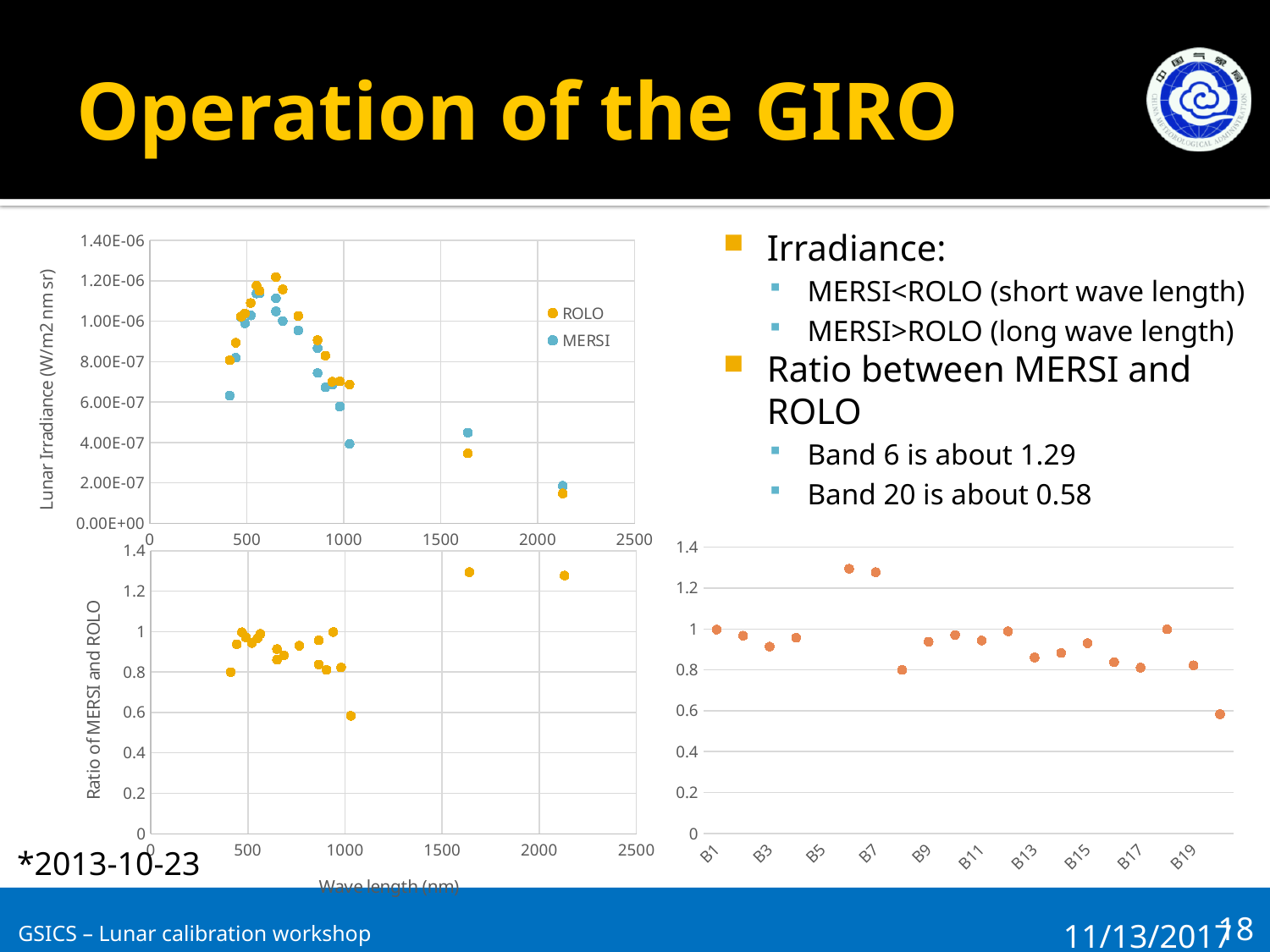
In the bottom-right chart of ratio by band, is the value for B20 greater or less than 0.8? less In the bottom-right chart of ratio by band, which is larger, the value for B6 or the value for B20? B6 In the bottom-right chart of ratio by band, is the value for B6 greater or less than 1.2? greater In the top-left Lunar Irradiance chart, at the longest wavelength plotted (around 2100 nm), which series has the larger value, MERSI or ROLO? MERSI In the bottom-right chart of ratio by band, how many bands (points) are plotted? 19 In the top-left Lunar Irradiance chart, how many series does the legend list? 2 In the top-left Lunar Irradiance chart, do the ROLO values rise or fall as wavelength increases from about 700 nm to 2500 nm? fall In the bottom-left chart of Ratio of MERSI and ROLO versus wavelength, is the lowest plotted ratio greater or less than 0.8? less In the bottom-right chart of ratio by band, which band has the lowest ratio? B20 In the top-left Lunar Irradiance chart, what are the two series named in the legend? ROLO and MERSI What kind of chart is the top-left chart of Lunar Irradiance versus wavelength? scatter chart